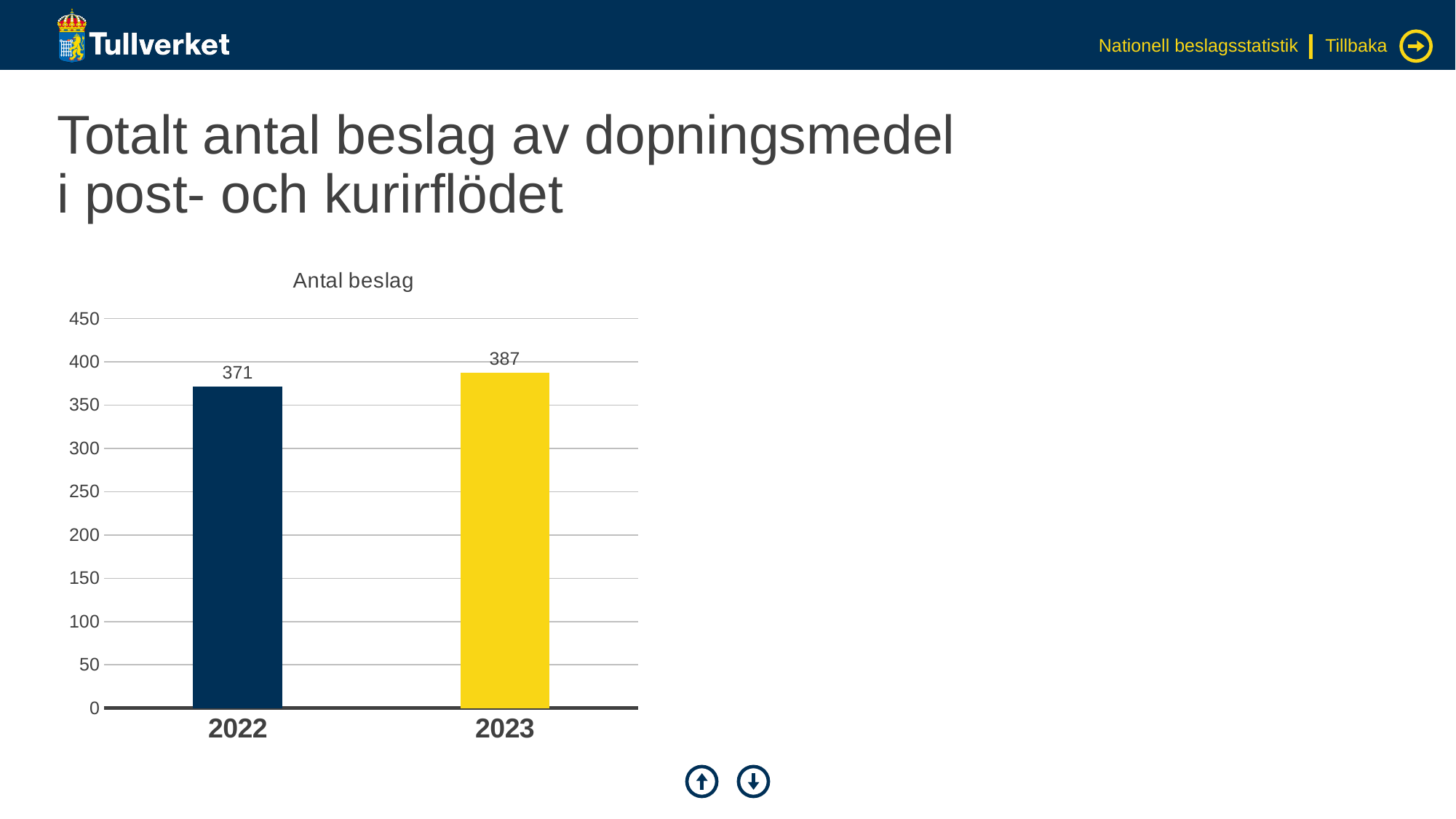
Which year has the lowest number of seizures? 2022 What is the title of the chart? Antal beslag Which year has the highest number of seizures? 2023 What is the value for 2023? 387 What kind of chart is shown on the slide? bar chart Which is larger, the value for 2022 or the value for 2023? 2023 Is the value for 2022 greater or less than 350? greater What is the difference between the values for 2023 and 2022? 16 What is the value for 2022? 371 Is the value for 2023 greater or less than 400? less How many years are shown on the x axis? 2 Do the values rise or fall from 2022 to 2023? rise